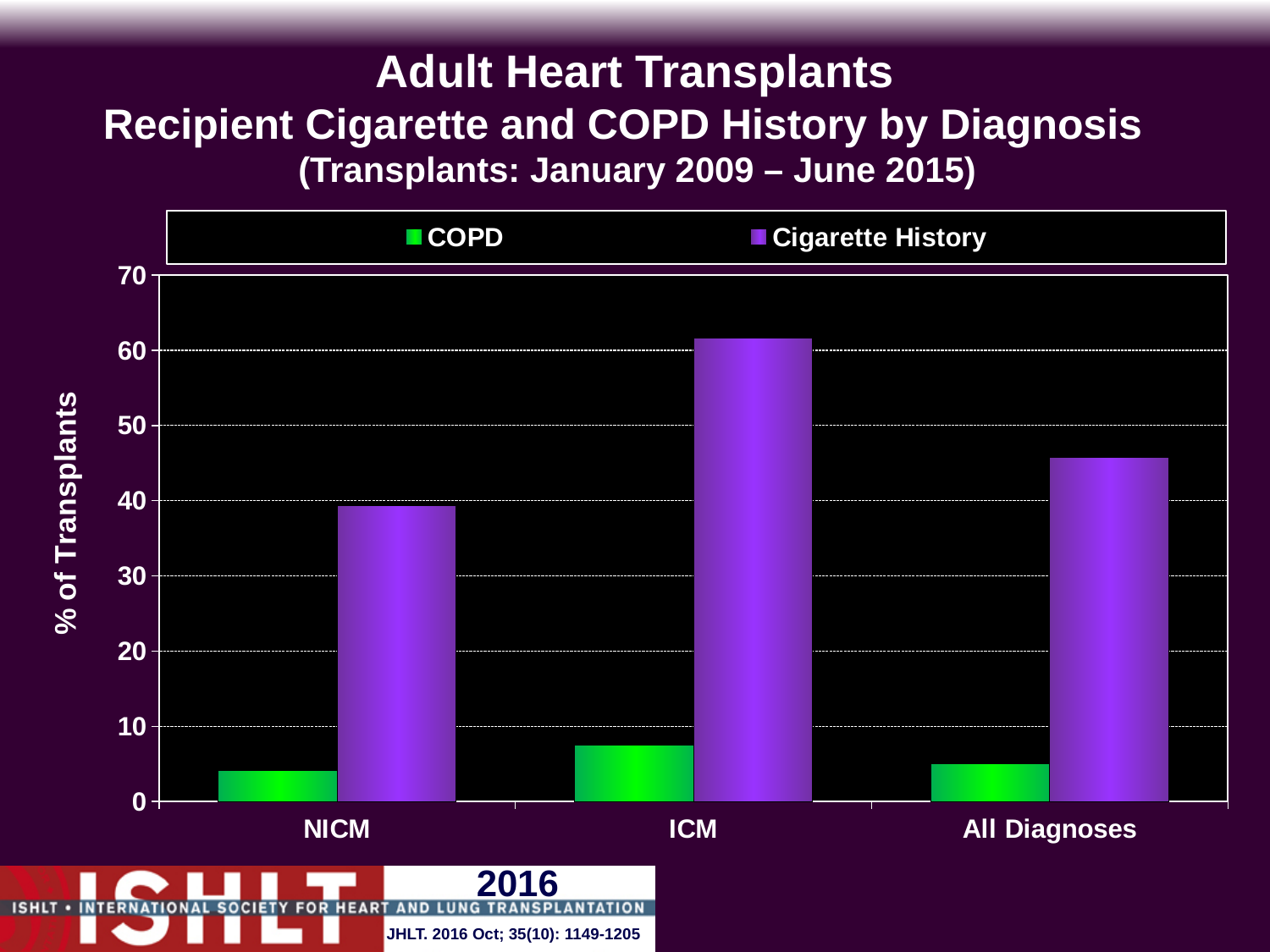
Which is larger, the Cigarette History value for ICM or for All Diagnoses? ICM Is the Cigarette History value for ICM greater or less than 50? greater Is the Cigarette History value for All Diagnoses greater or less than 50? less Which diagnosis category has the highest Cigarette History value? ICM How many diagnosis categories are shown on the x axis? 3 Which diagnosis category has the highest COPD value? ICM Is the COPD value for ICM greater or less than 10? less What kind of chart is shown on the slide? bar chart How many series does the legend list? 2 Which diagnosis category has the lowest Cigarette History value? NICM What is the label of the y axis? % of Transplants